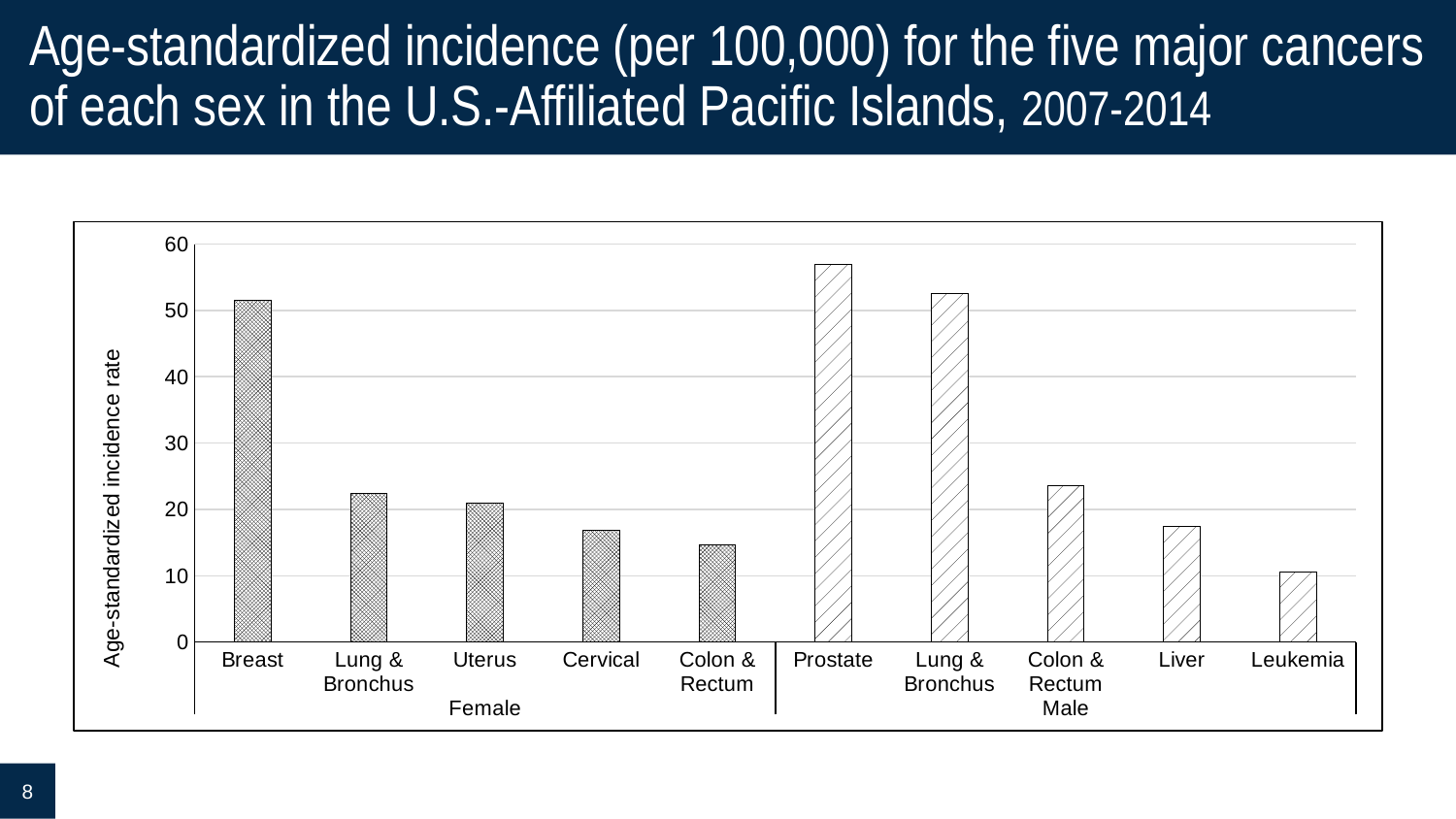
What kind of chart is shown on the slide? Bar chart Is the incidence rate for Breast greater or less than 50? greater Which cancer has the lowest age-standardized incidence rate on the chart? Leukemia How many cancer categories are plotted on the chart in total? 10 Is the incidence rate for Cervical greater or less than 20? less Which is larger, the incidence rate for Uterus or for Cervical? Uterus Which cancer has the highest age-standardized incidence rate on the chart? Prostate What is the label on the vertical axis of the chart? Age-standardized incidence rate Which is larger, the incidence rate for Breast or for Prostate? Prostate Among the female cancers, which has the highest incidence rate? Breast Among the female cancers, which has the lowest incidence rate? Colon & Rectum Which is larger, the Colon & Rectum incidence rate for males or for females? Male